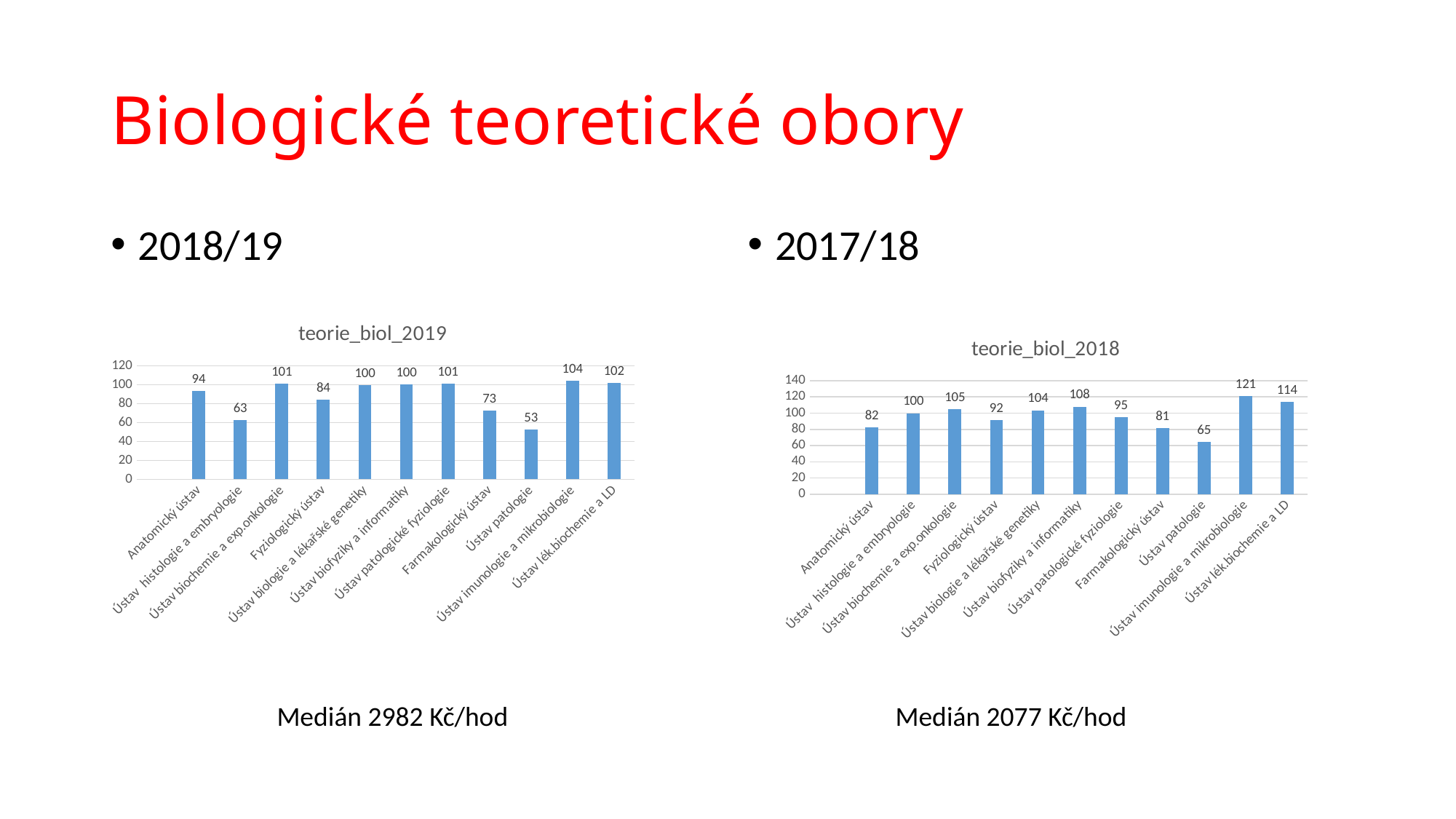
In the teorie_biol_2019 chart, what is the value for Ústav histologie a embryologie? 63 How many categories are shown in the teorie_biol_2019 chart? 11 In the teorie_biol_2018 chart, what is the difference between the values for Ústav biofyziky a informatiky and Anatomický ústav? 26 In the teorie_biol_2019 chart, which category has the highest value? Ústav imunologie a mikrobiologie In the teorie_biol_2018 chart, is the value for Farmakologický ústav greater or less than 100? less In the teorie_biol_2018 chart, which category has the lowest value? Ústav patologie In the teorie_biol_2019 chart, what is the difference between the values for Ústav imunologie a mikrobiologie and Ústav patologie? 51 In the teorie_biol_2019 chart, which is larger: the value for Anatomický ústav or the value for Fyziologický ústav? Anatomický ústav In the teorie_biol_2019 chart, what is the value for Ústav patologie? 53 In the teorie_biol_2018 chart, what is the value for Ústav imunologie a mikrobiologie? 121 What kind of chart is teorie_biol_2018? bar chart What is the title of the chart on the left side of the slide? teorie_biol_2019